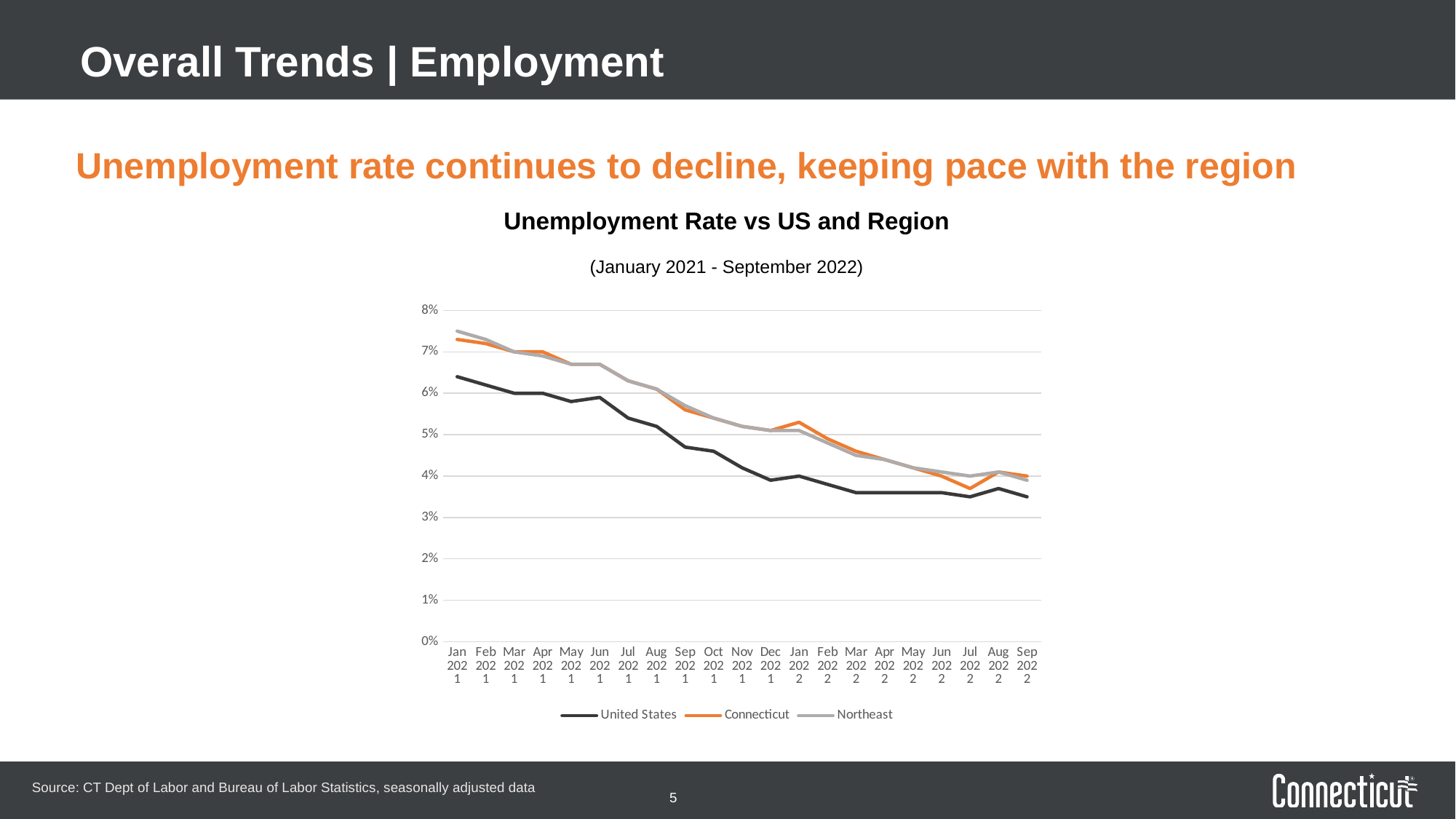
Which series has the lowest unemployment rate across the whole period? United States Is the Connecticut unemployment rate in Sep 2022 greater or less than 5%? less How many monthly data points are plotted along the x axis? 21 Do the unemployment rates generally rise or fall from January 2021 to September 2022? Fall Is the Connecticut unemployment rate in Jan 2021 greater or less than 7%? greater Which series is drawn in orange? Connecticut What is the title of the chart? Unemployment Rate vs US and Region Is the United States unemployment rate in Sep 2022 greater or less than 4%? less What kind of chart is shown on the slide? Line chart In Jan 2022, which has the higher unemployment rate, Connecticut or the United States? Connecticut How many series does the legend list? 3